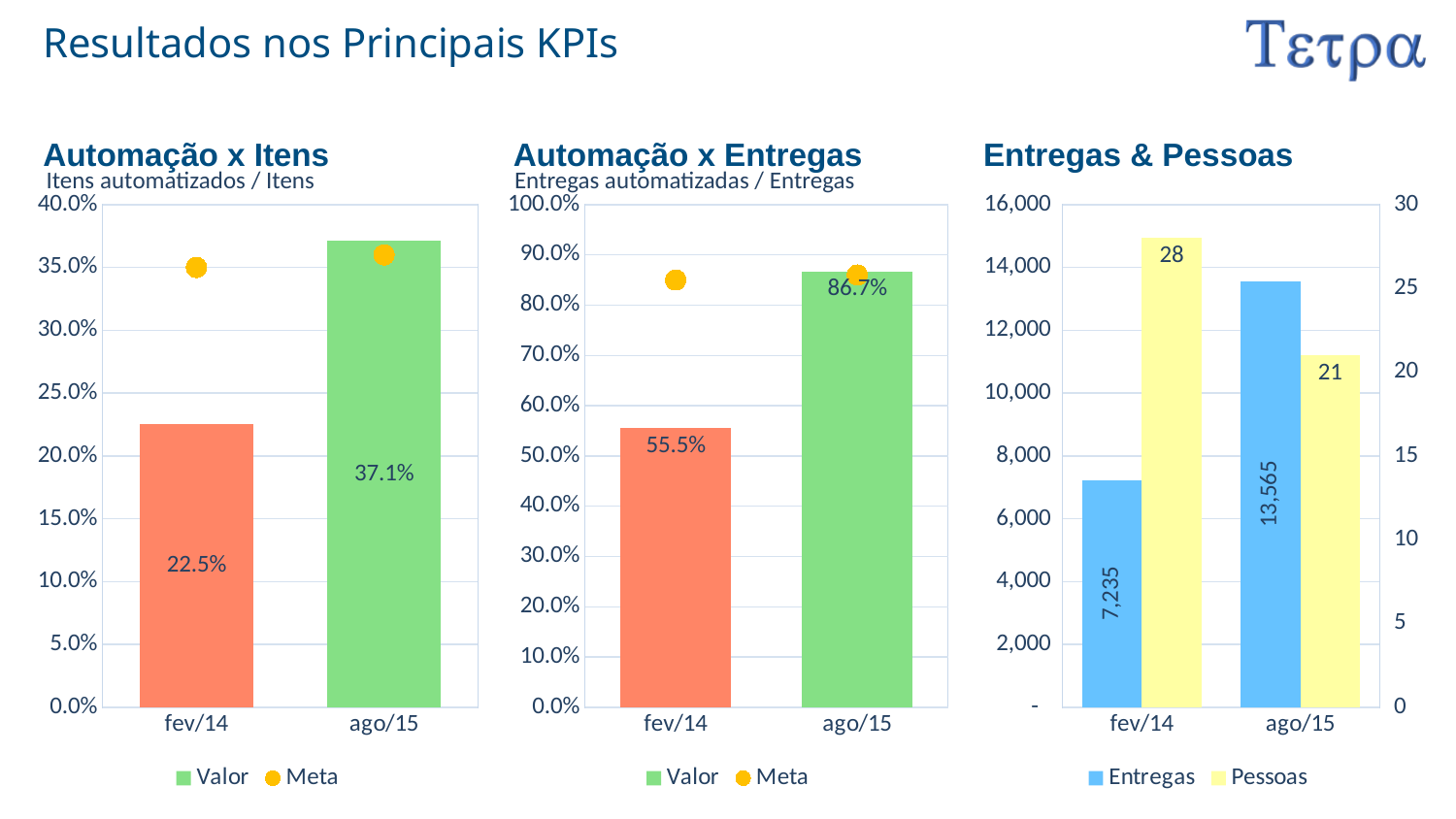
In the 'Entregas & Pessoas' chart, what is the difference in Entregas between ago/15 and fev/14? 6,330 In the 'Automação x Entregas' chart, does the Valor rise or fall from fev/14 to ago/15? rise In the 'Automação x Itens' chart, what is the Valor for ago/15? 37.1% In the 'Automação x Itens' chart, by how many percentage points did the Valor increase from fev/14 to ago/15? 14.6 percentage points In the 'Automação x Itens' chart, what is the Valor for fev/14? 22.5% In the 'Entregas & Pessoas' chart, what is the Entregas value for ago/15? 13,565 In the 'Automação x Entregas' chart, what is the Valor for fev/14? 55.5% In the 'Entregas & Pessoas' chart, what is the Pessoas value for fev/14? 28 In the 'Automação x Itens' chart, is the Meta for fev/14 greater or less than 30.0%? greater In the 'Automação x Entregas' chart, what is the Valor for ago/15? 86.7% How many series does the legend of the 'Entregas & Pessoas' chart list? 2 In the 'Automação x Entregas' chart, is the Meta for fev/14 greater or less than 80.0%? greater